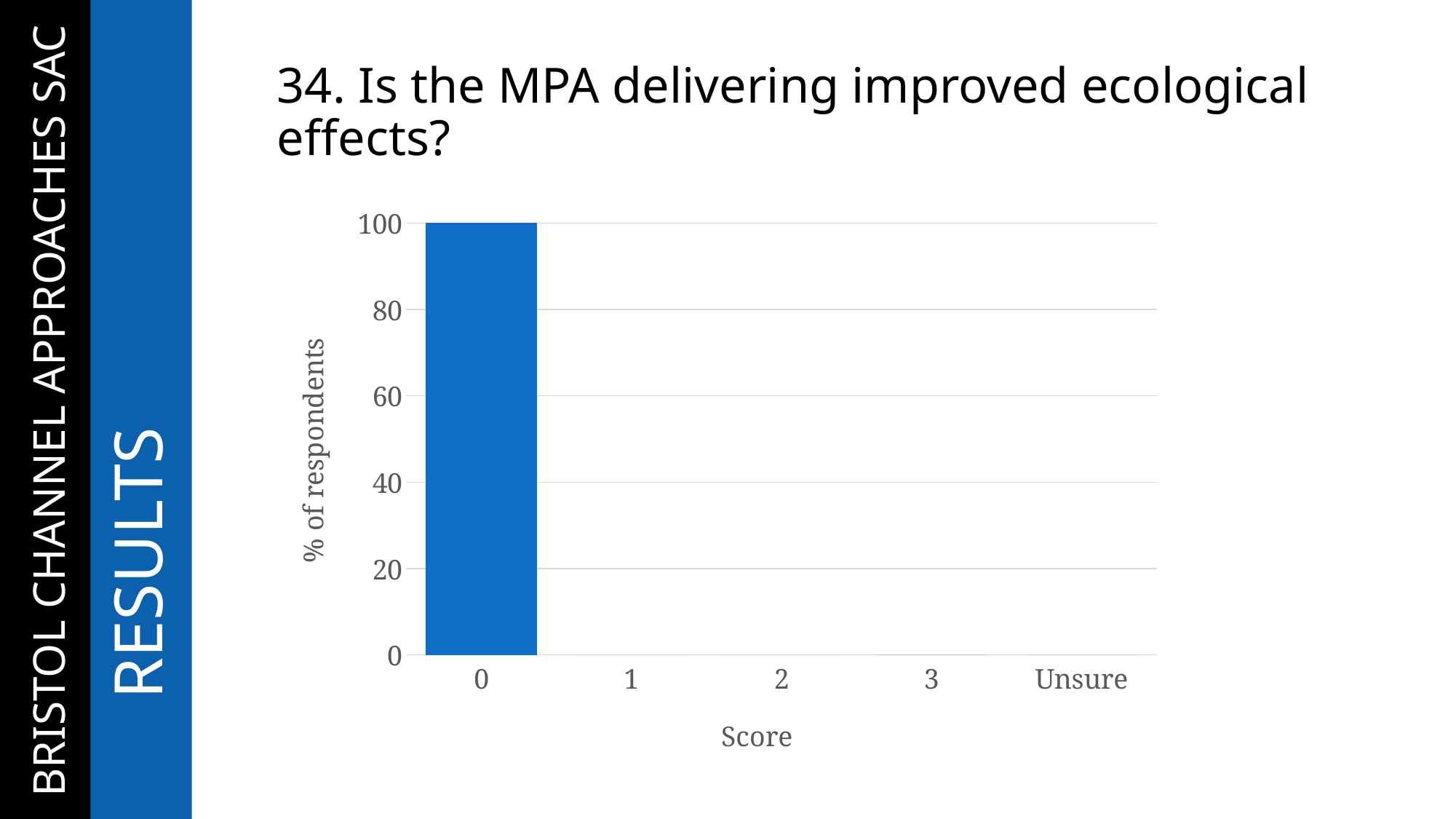
What is the label of the y axis? % of respondents What type of chart is shown on the slide? bar chart What is the % of respondents for the Unsure category? 0 Which score category has the highest % of respondents? 0 Is the value for score 0 greater or less than 80? greater How many categories are shown on the x axis? 5 What is the difference between the % of respondents for score 0 and for score 2? 100 What is the label of the x axis? Score Do the values rise or fall from score 0 to score 1? fall What is the % of respondents for score 0? 100 What is the % of respondents for score 1? 0 Which is larger, the value for score 0 or the value for score 3? score 0